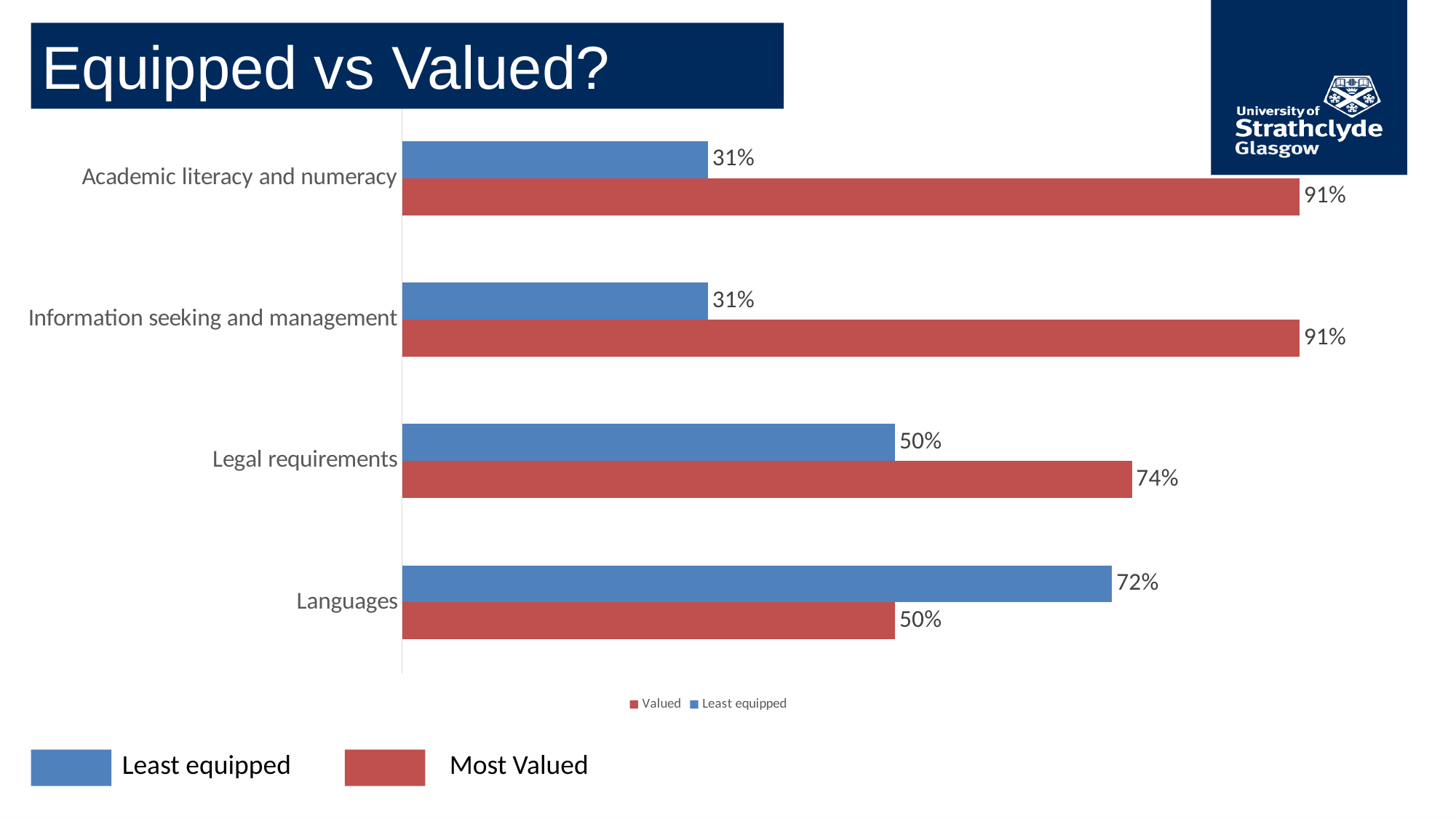
What is the Valued value for Academic literacy and numeracy? 91% How many categories are shown on the chart? 4 What kind of chart is shown on the slide? Bar chart What is the difference between the Least equipped and Valued values for Languages? 22% What is the difference between the Valued and Least equipped values for Information seeking and management? 60% How many series does the chart legend list? 2 What is the Least equipped value for Languages? 72% Which category has the lowest Valued value? Languages What is the Valued value for Legal requirements? 74% Which category has the highest Least equipped value? Languages For Legal requirements, which is larger: the Valued value or the Least equipped value? Valued What is the Least equipped value for Legal requirements? 50%